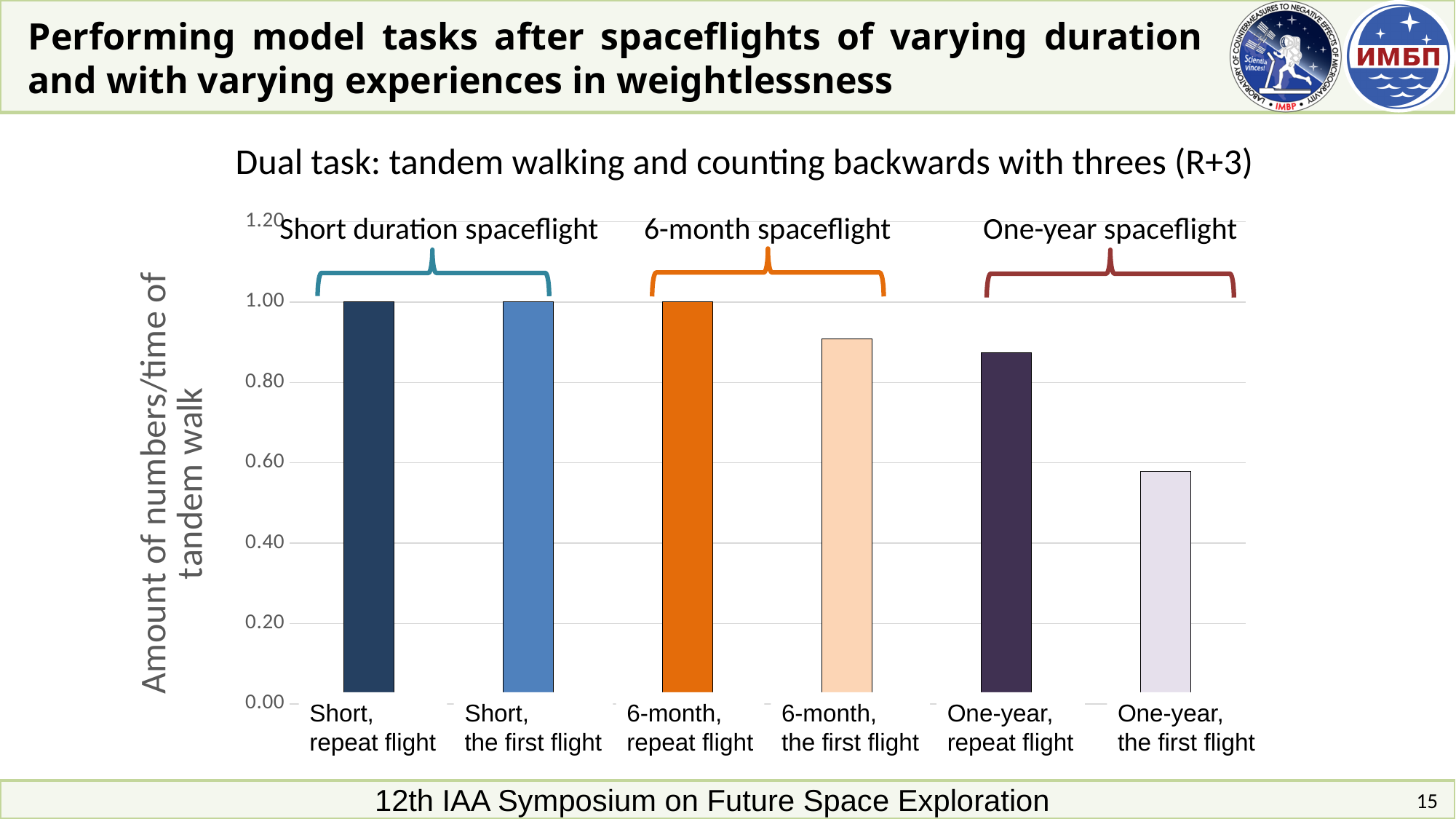
What is the value for "6-month, repeat flight"? 1.00 Is the value for "One-year, repeat flight" greater or less than 1.00? less Which is larger: the value for "6-month, the first flight" or "One-year, the first flight"? 6-month, the first flight What is the value for "Short, repeat flight"? 1.00 Which category has the lowest value? One-year, the first flight Is the value for "6-month, the first flight" greater or less than 0.80? greater Do the bar values generally rise or fall from left to right along the x axis? fall Is the value for "One-year, the first flight" greater or less than 0.80? less What is the title of the chart? Dual task: tandem walking and counting backwards with threes (R+3) How many bars are plotted in the chart? 6 Which is larger: the value for "One-year, repeat flight" or "One-year, the first flight"? One-year, repeat flight What kind of chart is shown on the slide? bar chart